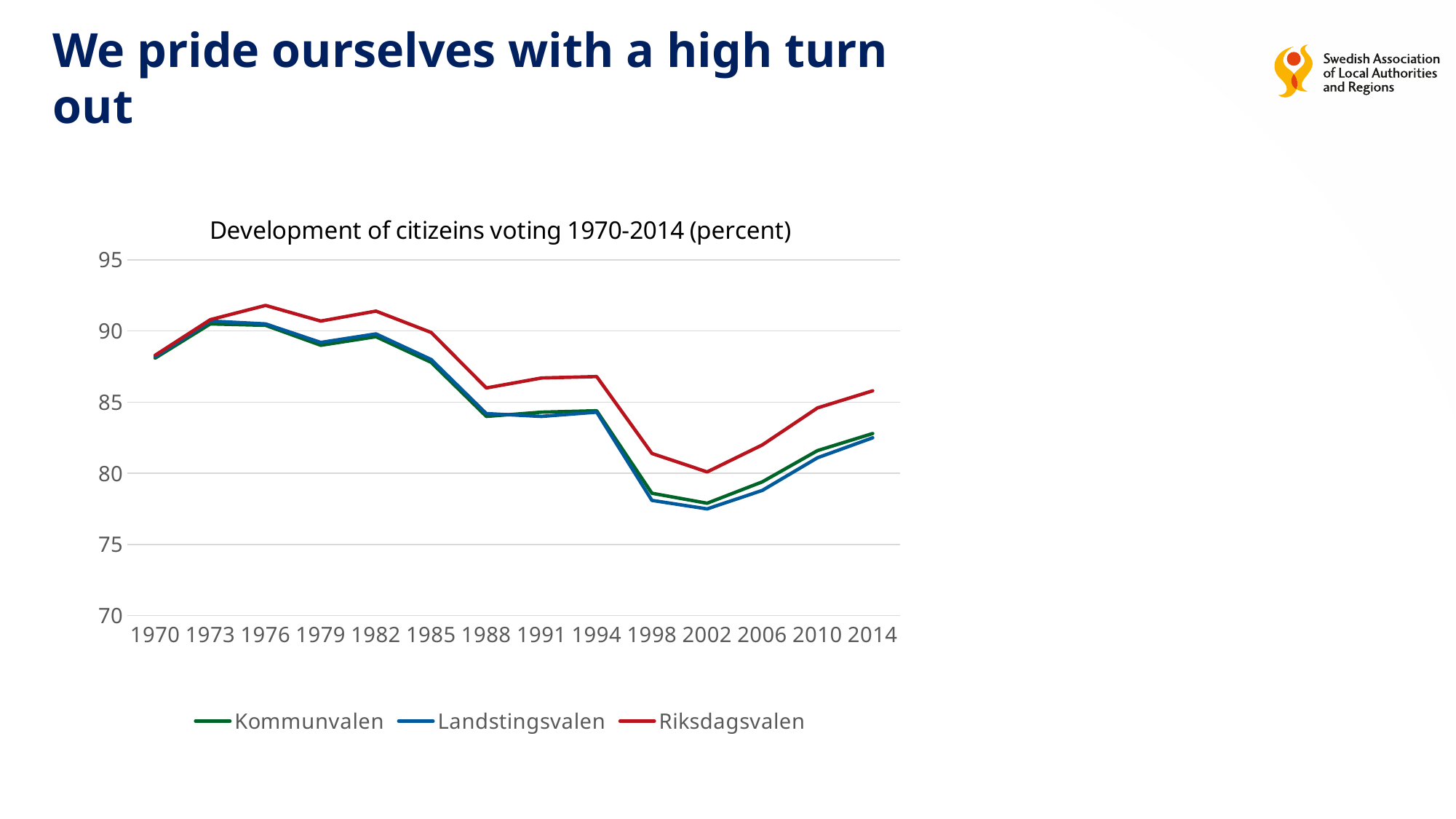
What is the title of the chart? Development of citizeins voting 1970-2014 (percent) Do the values rise or fall from 2002 to 2014? rise How many election years are plotted along the x axis? 14 Is the value for Kommunvalen in 2002 greater or less than 80? less What kind of chart is shown on the slide? line chart In which year is the Riksdagsvalen series at its lowest? 2002 Is the value for Riksdagsvalen in 2014 greater or less than 85? greater Which series has the highest value in 2014? Riksdagsvalen Which series is drawn in red? Riksdagsvalen How many series does the legend list? 3 Is the value for Riksdagsvalen in 1976 greater or less than 90? greater